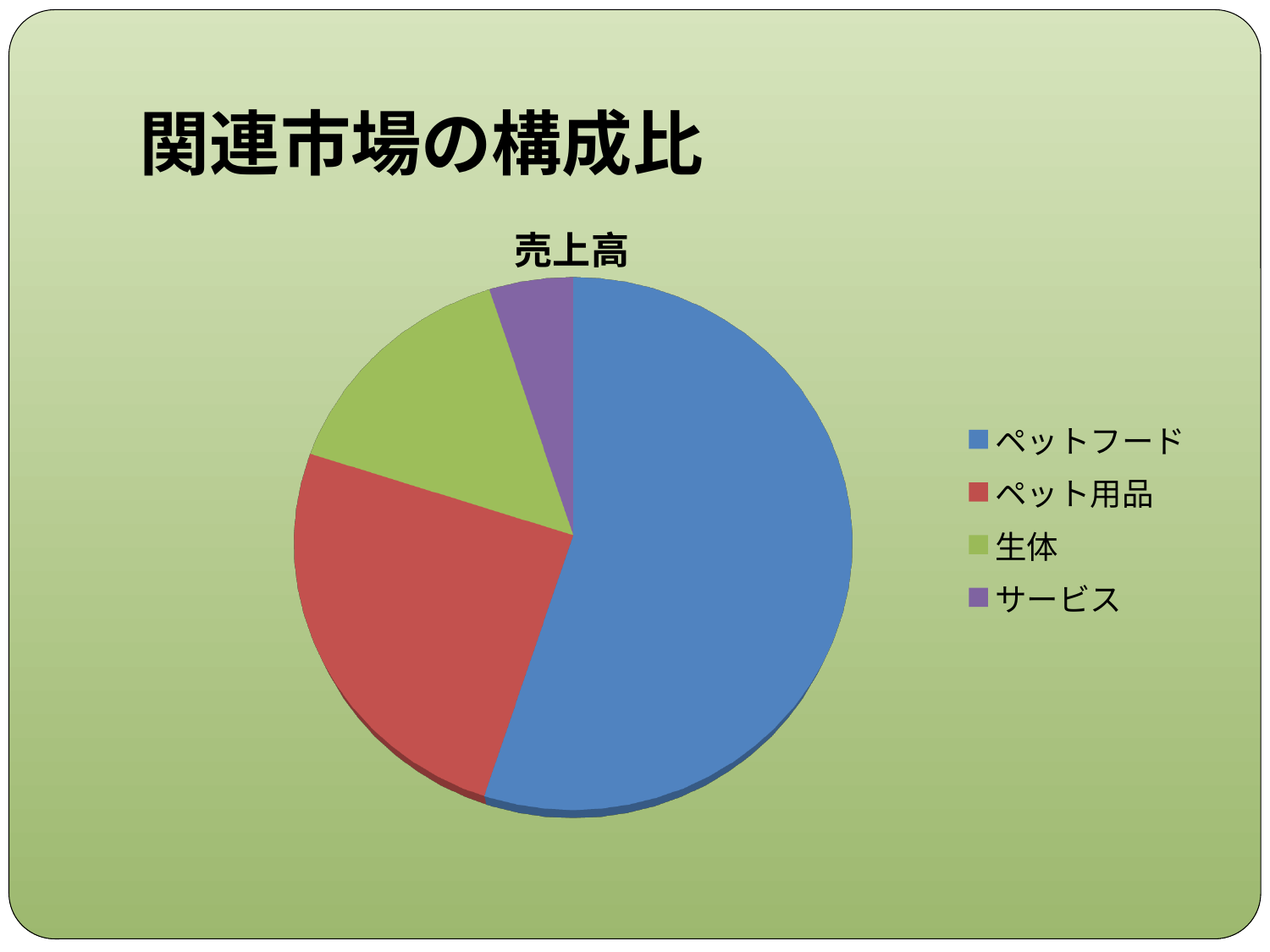
Which slice is larger, 生体 or サービス? 生体 Which category has the largest slice of the pie? ペットフード Which category is shown in blue? ペットフード How many categories does the pie chart have? 4 How many entries does the legend list? 4 Which category has the smallest slice of the pie? サービス What is the title of the chart? 売上高 Which slice is larger, ペットフード or ペット用品? ペットフード What kind of chart is shown on the slide? pie chart Which slice is larger, ペット用品 or 生体? ペット用品 Which colour represents ペット用品 in the pie chart? red